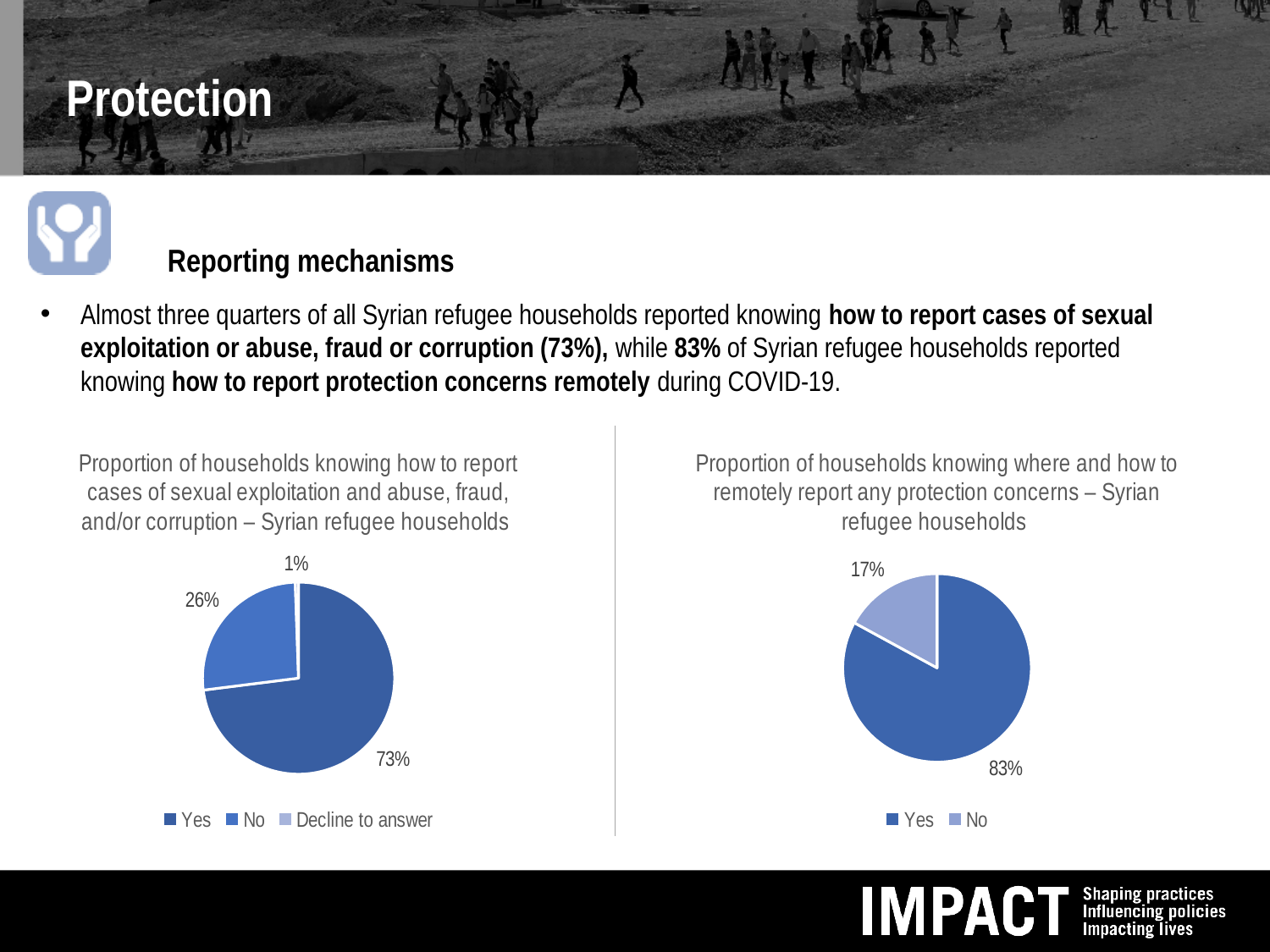
Which chart has the larger Yes share: the left pie chart or the right pie chart? The right pie chart How many categories does the legend of the left pie chart list? 3 In the left pie chart (knowing how to report cases of sexual exploitation and abuse, fraud, and/or corruption), what percentage of households answered No? 26% In the right pie chart (knowing where and how to remotely report any protection concerns), what percentage of households answered Yes? 83% In the left pie chart (knowing how to report cases of sexual exploitation and abuse, fraud, and/or corruption), what percentage of households declined to answer? 1% In the right pie chart (knowing where and how to remotely report any protection concerns), which response has the largest share? Yes In the right pie chart (knowing where and how to remotely report any protection concerns), what percentage of households answered No? 17% In the right pie chart (knowing where and how to remotely report any protection concerns), what is the difference between the Yes and No shares? 66% In the left pie chart (knowing how to report cases of sexual exploitation and abuse, fraud, and/or corruption), what percentage of households answered Yes? 73% In the left pie chart (knowing how to report cases of sexual exploitation and abuse, fraud, and/or corruption), which response has the smallest share? Decline to answer In the left pie chart (knowing how to report cases of sexual exploitation and abuse, fraud, and/or corruption), what is the difference between the Yes and No shares? 47% What type of chart is used on the right side of the slide (knowing where and how to remotely report any protection concerns)? Pie chart